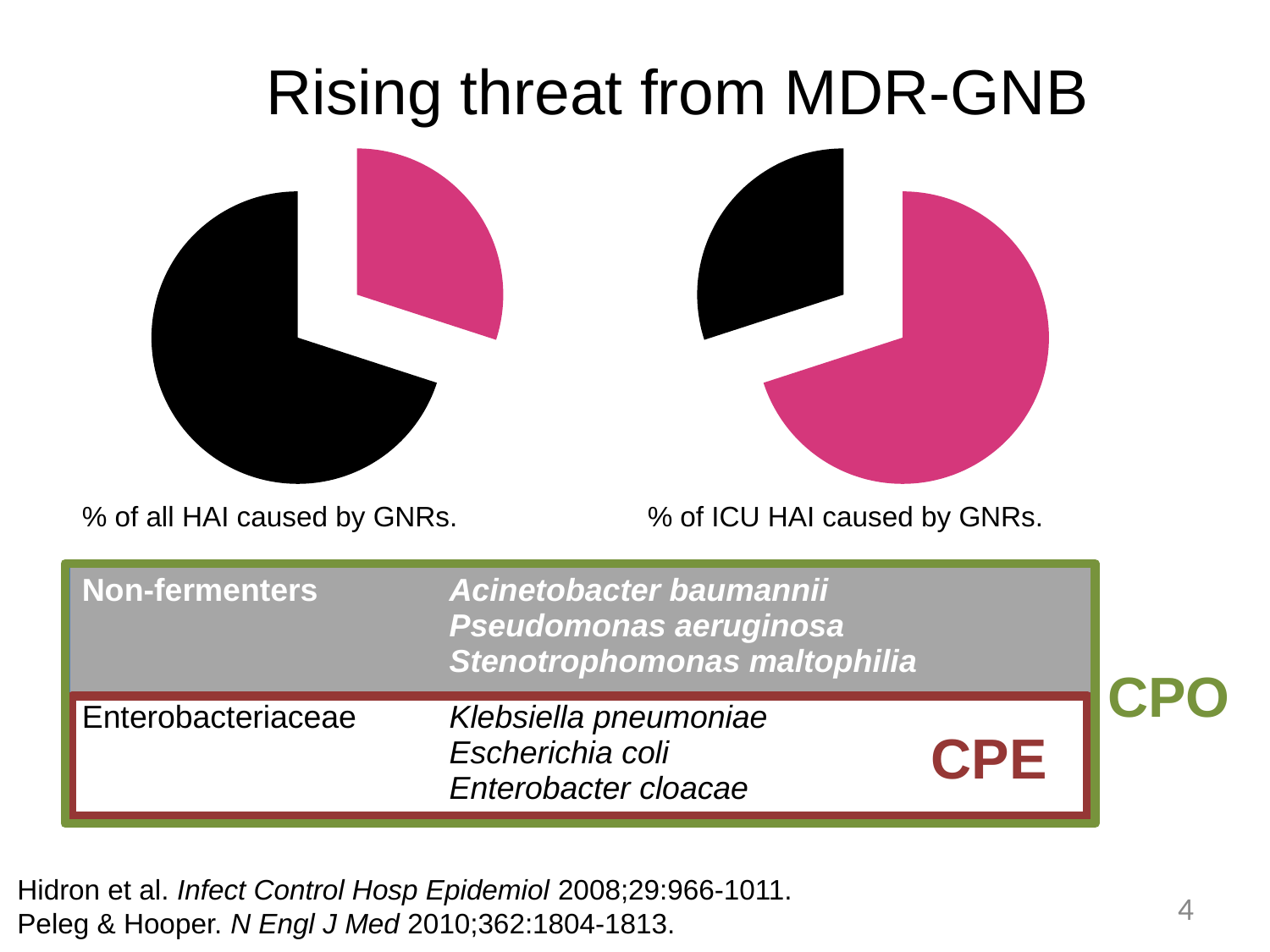
What kind of chart is the left chart, captioned "% of all HAI caused by GNRs."? pie chart What kind of chart is the right chart, captioned "% of ICU HAI caused by GNRs."? pie chart Which of the two pie charts has the larger pink slice, the left one (all HAI) or the right one (ICU HAI)? the right one (ICU HAI) What is the caption under the right pie chart? % of ICU HAI caused by GNRs. In the left pie chart (% of all HAI caused by GNRs), which colour is the smallest slice? pink In the left pie chart (% of all HAI caused by GNRs), which slice is larger, the black one or the pink one? the black one How many slices does the left pie chart (% of all HAI caused by GNRs) have? 2 What is the caption under the left pie chart? % of all HAI caused by GNRs. In the right pie chart (% of ICU HAI caused by GNRs), which slice is larger, the black one or the pink one? the pink one How many slices does the right pie chart (% of ICU HAI caused by GNRs) have? 2 In the right pie chart (% of ICU HAI caused by GNRs), which colour is the largest slice? pink